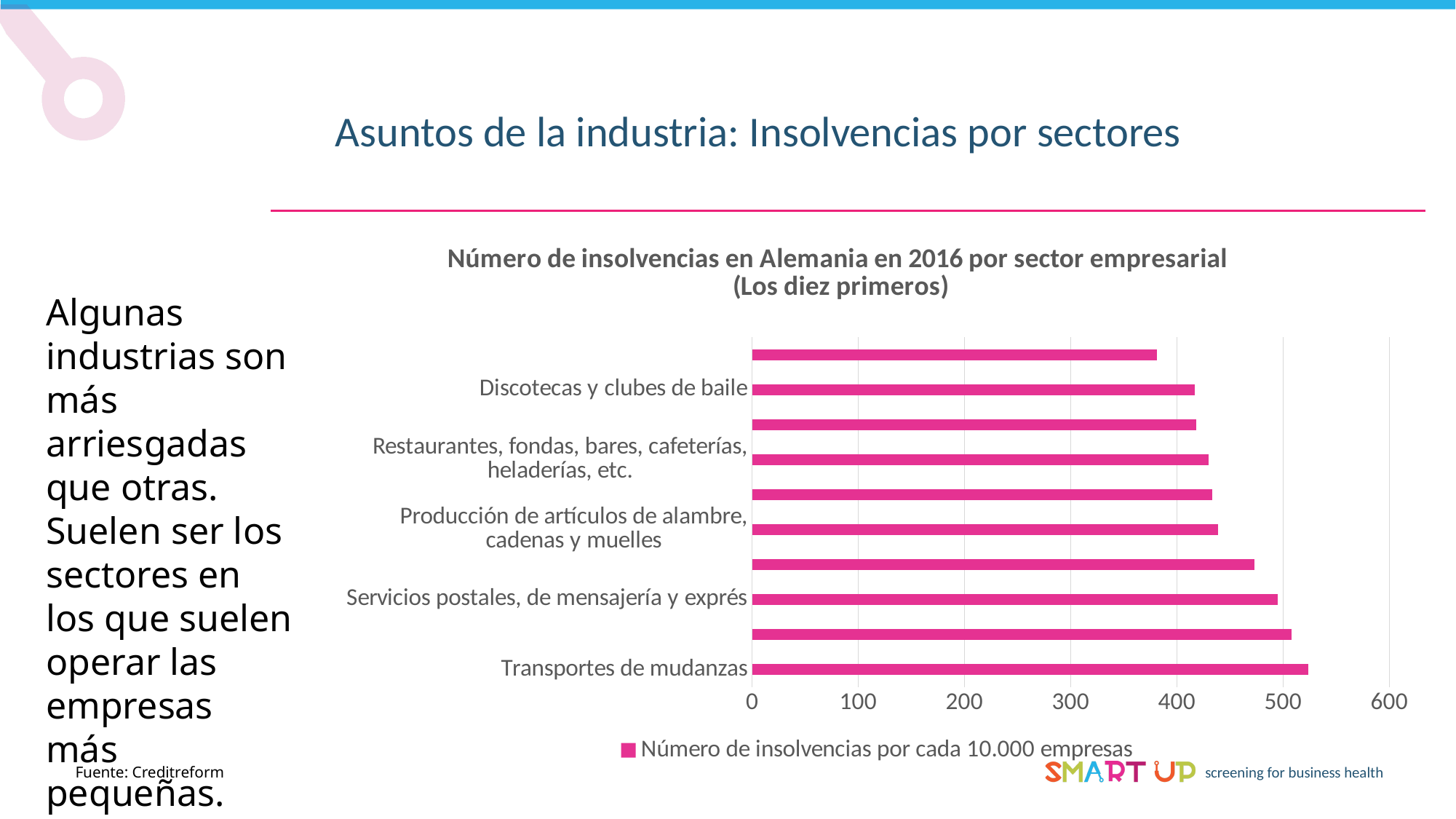
Which has more insolvencies: Transportes de mudanzas or Discotecas y clubes de baile? Transportes de mudanzas Is the value for Producción de artículos de alambre, cadenas y muelles greater or less than 500? less How many bars are plotted in the chart? 10 Which labelled sector has the highest number of insolvencies? Transportes de mudanzas What is the title of the chart? Número de insolvencias en Alemania en 2016 por sector empresarial (Los diez primeros) Which has more insolvencies: Servicios postales, de mensajería y exprés or Restaurantes, fondas, bares, cafeterías, heladerías, etc.? Servicios postales, de mensajería y exprés What is the legend entry of the chart? Número de insolvencias por cada 10.000 empresas Is the value for Transportes de mudanzas greater or less than 500? greater Is the value for Servicios postales, de mensajería y exprés greater or less than 400? greater What kind of chart is shown on the slide? bar chart How many series does the legend list? 1